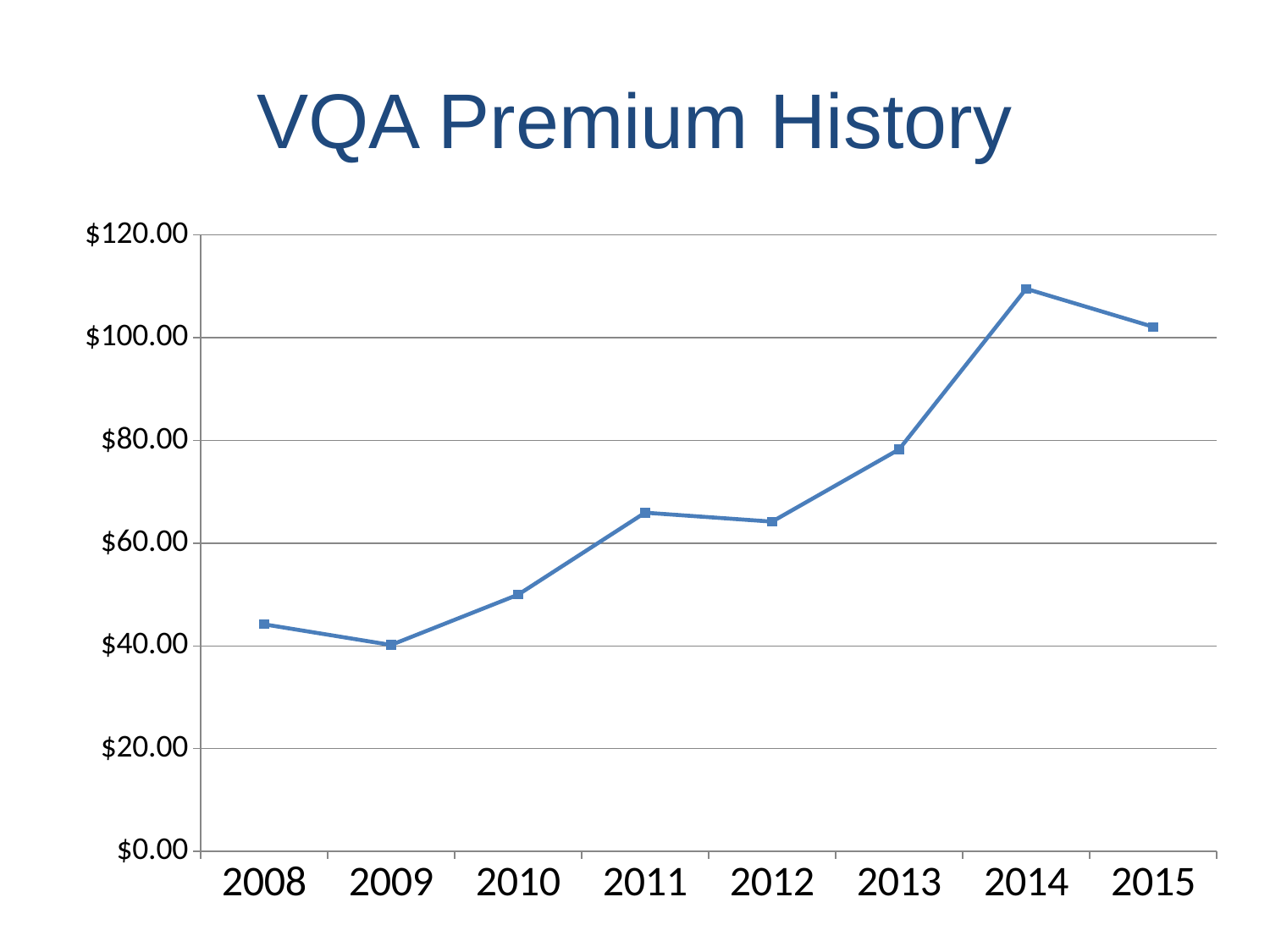
Which year has the lowest premium? 2009 How many years are plotted on the x axis? 8 Is the value for 2010 greater or less than $60.00? less Which year has the larger premium, 2014 or 2015? 2014 Is the value for 2013 greater or less than $60.00? greater Which year has the highest premium? 2014 Overall, does the premium rise or fall from 2008 to 2015? rise What is the title of the chart? VQA Premium History What kind of chart is shown on the slide? line chart Is the value for 2011 greater or less than $60.00? greater Which year has the larger premium, 2010 or 2013? 2013